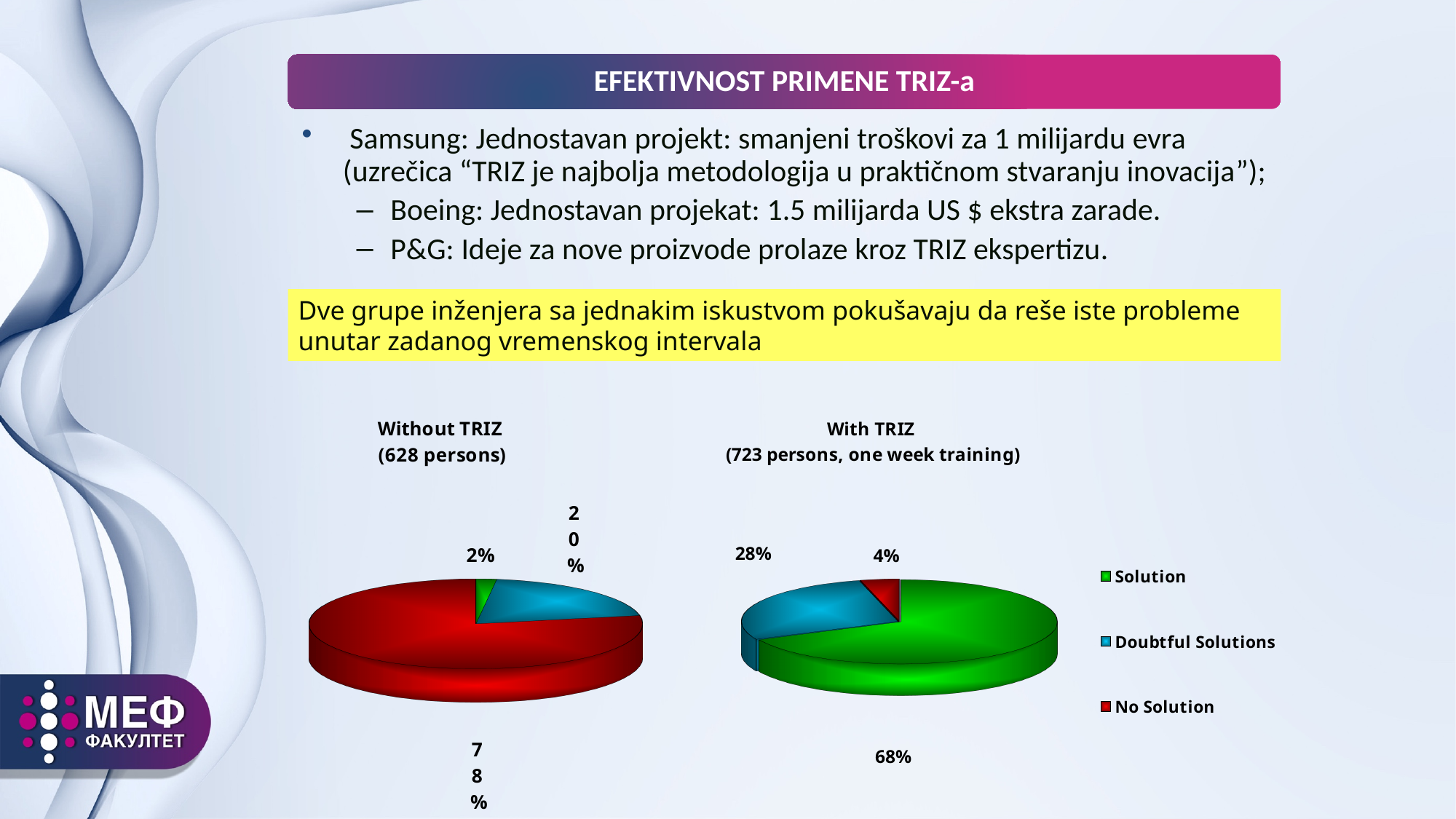
In the "With TRIZ" chart, which category has the largest slice? Solution In the "Without TRIZ" chart, what share of the pie is Doubtful Solutions? 20% In the "Without TRIZ" chart, what share of the pie is No Solution? 78% Which is larger: the Doubtful Solutions share in the "With TRIZ" chart or in the "Without TRIZ" chart? With TRIZ In the "With TRIZ" chart, what share of the pie is Solution? 68% What is the difference between the Solution share in the "With TRIZ" chart and the Solution share in the "Without TRIZ" chart? 66% In the "Without TRIZ" chart, which category has the smallest slice? Solution In the "With TRIZ" chart, what share of the pie is No Solution? 4% What type of chart is used for the "With TRIZ" data? Pie chart How many categories does the legend list for the pie charts? 3 In the "Without TRIZ" chart, what share of the pie is Solution? 2% In the legend, which colour represents No Solution? Red